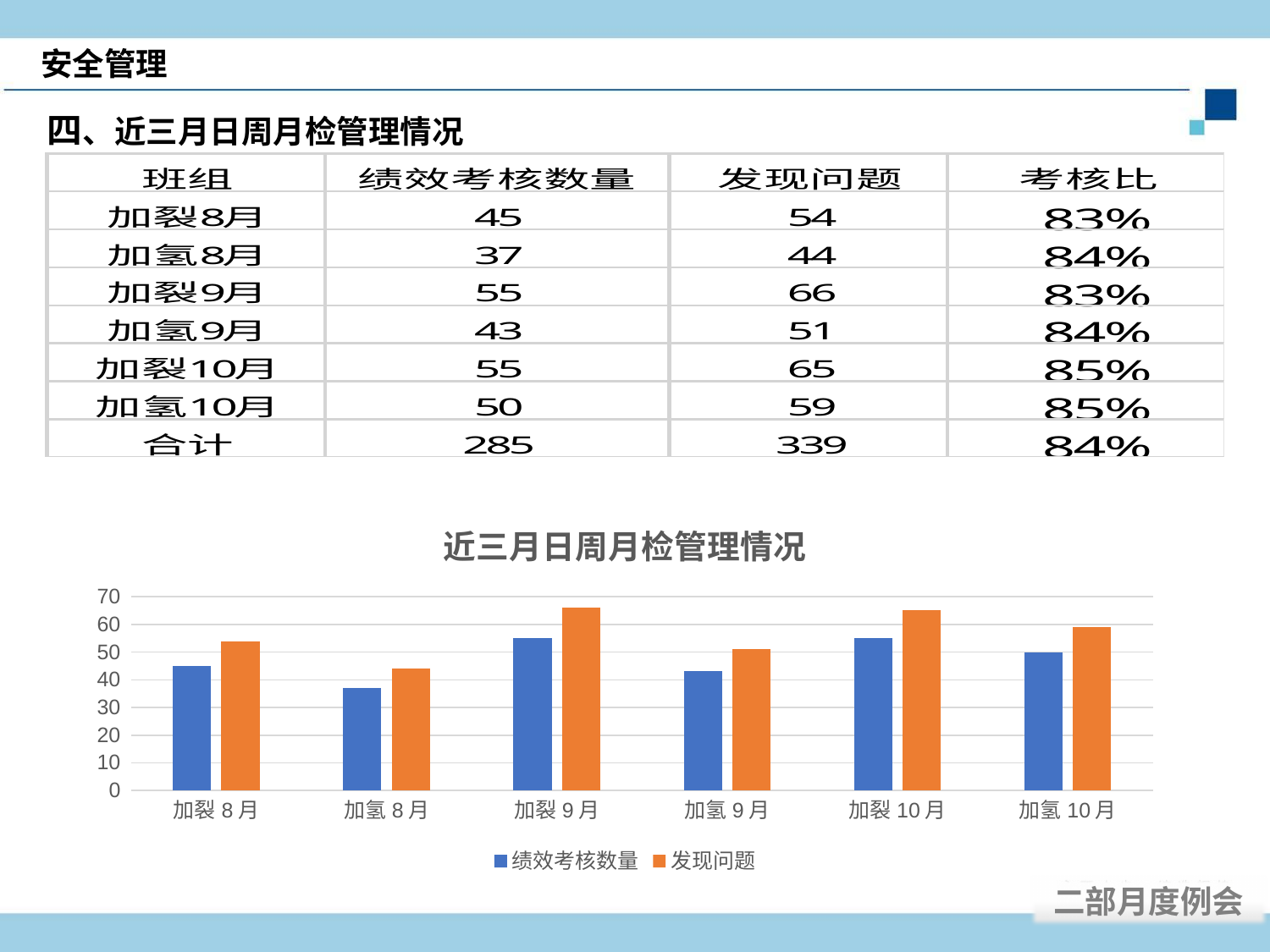
What is the 绩效考核数量 value for 加氢 8 月? 37 How many categories are shown on the x axis of the chart? 6 Is the 发现问题 value for 加裂 10 月 greater or less than 60? greater What is the difference between the 发现问题 and 绩效考核数量 values for 加氢 10 月? 9 What kind of chart is shown on the slide? bar chart How many series does the chart legend list? 2 What is the title of the chart? 近三月日周月检管理情况 Which category has the lowest 绩效考核数量 value? 加氢 8 月 Is the 绩效考核数量 value for 加氢 9 月 greater or less than 50? less What is the 发现问题 value for 加裂 9 月? 66 Which category has the highest 发现问题 value? 加裂 9 月 Which series is drawn in orange in the chart? 发现问题